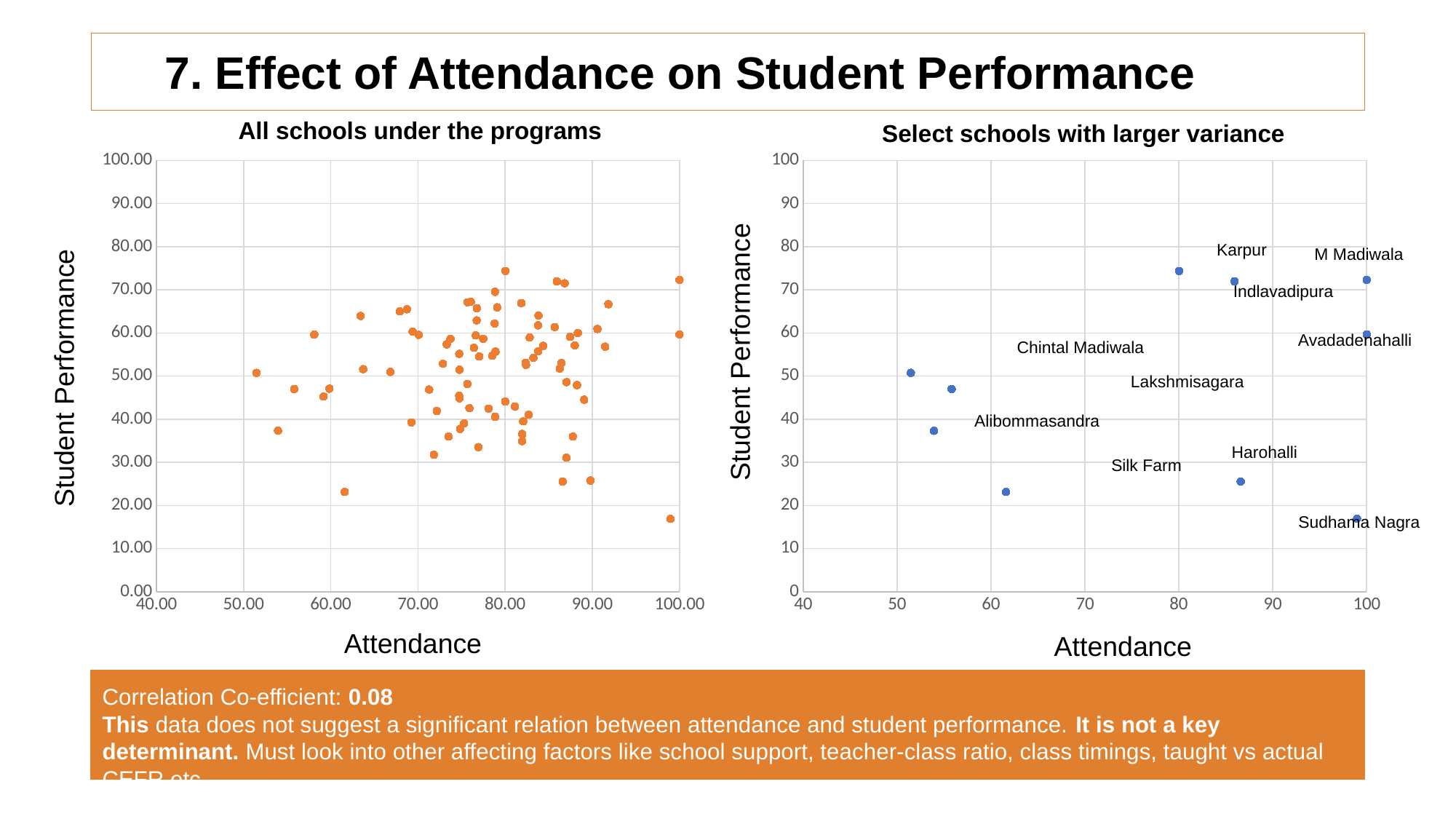
In the 'Select schools with larger variance' chart, is the student performance for Silk Farm greater or less than 30? less What type of chart is 'All schools under the programs'? scatter chart What correlation coefficient is reported on the slide for attendance and student performance? 0.08 In the 'Select schools with larger variance' chart, is the student performance for Sudhama Nagra greater or less than 20? less In the 'Select schools with larger variance' chart, is the attendance for Sudhama Nagra greater or less than 90? greater In the 'Select schools with larger variance' chart, which school has the lowest student performance? Sudhama Nagra What is the x-axis label of the 'All schools under the programs' chart? Attendance How many schools are plotted in the 'Select schools with larger variance' chart? 10 In the 'Select schools with larger variance' chart, which school has higher attendance, M Madiwala or Alibommasandra? M Madiwala In the 'Select schools with larger variance' chart, which school has higher student performance, Karpur or Harohalli? Karpur